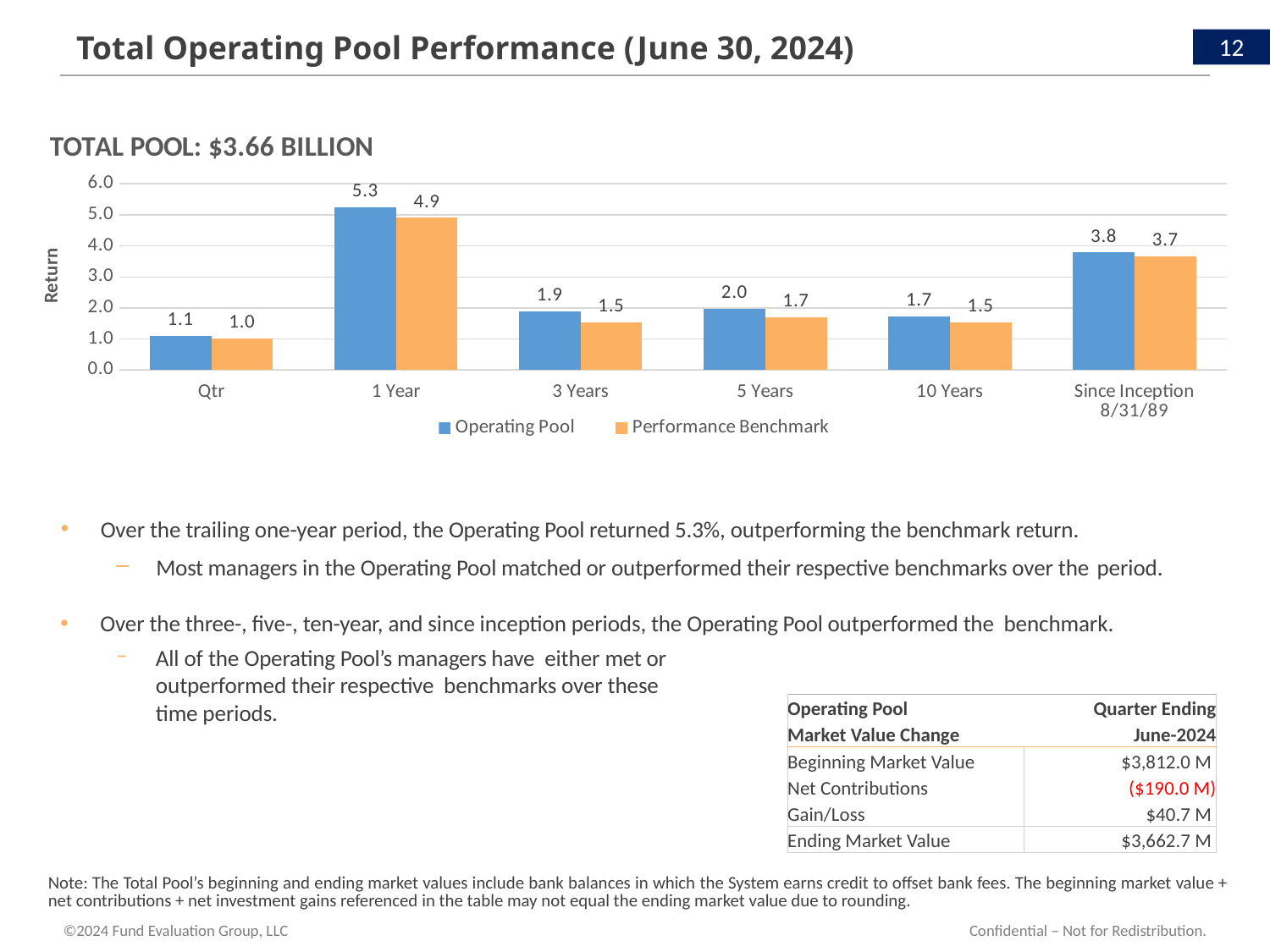
Which period has the lowest Performance Benchmark return? Qtr What is the label of the y axis of the chart? Return What is the Operating Pool return for the Since Inception 8/31/89 period? 3.8 Which period has the highest Operating Pool return? 1 Year What is the Performance Benchmark return for the 10 Years period? 1.5 What is the difference between the Operating Pool and Performance Benchmark returns for the 3 Years period? 0.4 Is the Operating Pool return for the 1 Year period greater or less than 5.0? greater What is the Operating Pool return for the 1 Year period? 5.3 Which is larger for the 5 Years period, the Operating Pool return or the Performance Benchmark return? Operating Pool What type of chart is shown on the slide? Bar chart How many series does the chart legend list? 2 How many time periods are shown on the x axis of the chart? 6